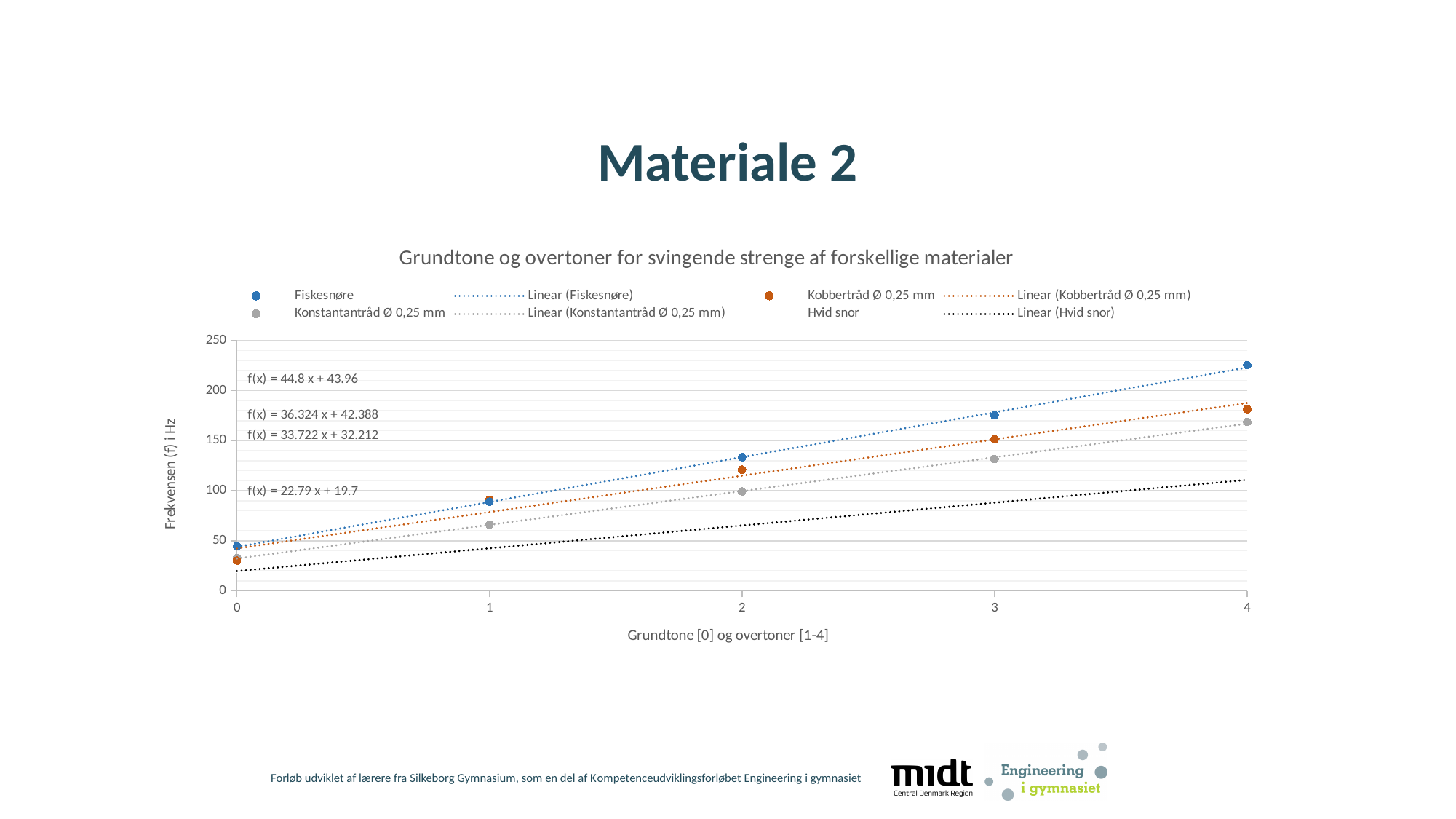
Is the value for Kobbertråd Ø 0,25 mm at x = 2 greater or less than 100? greater Is the value for Fiskesnøre at x = 4 greater or less than 200? greater At x = 4, which is larger: the value for Fiskesnøre or the value for Kobbertråd Ø 0,25 mm? Fiskesnøre Which trendline equation printed on the chart has the largest slope? f(x) = 44.8 x + 43.96 What kind of chart is shown on the slide? scatter chart Is the value for Konstantantråd Ø 0,25 mm at x = 4 greater or less than 150? greater How many entries does the chart legend list? 8 What is the title of the chart? Grundtone og overtoner for svingende strenge af forskellige materialer What is the label of the vertical axis? Frekvensen (f) i Hz Do the values for Fiskesnøre rise or fall as x increases from 0 to 4? rise Which series has the highest value at x = 4? Fiskesnøre